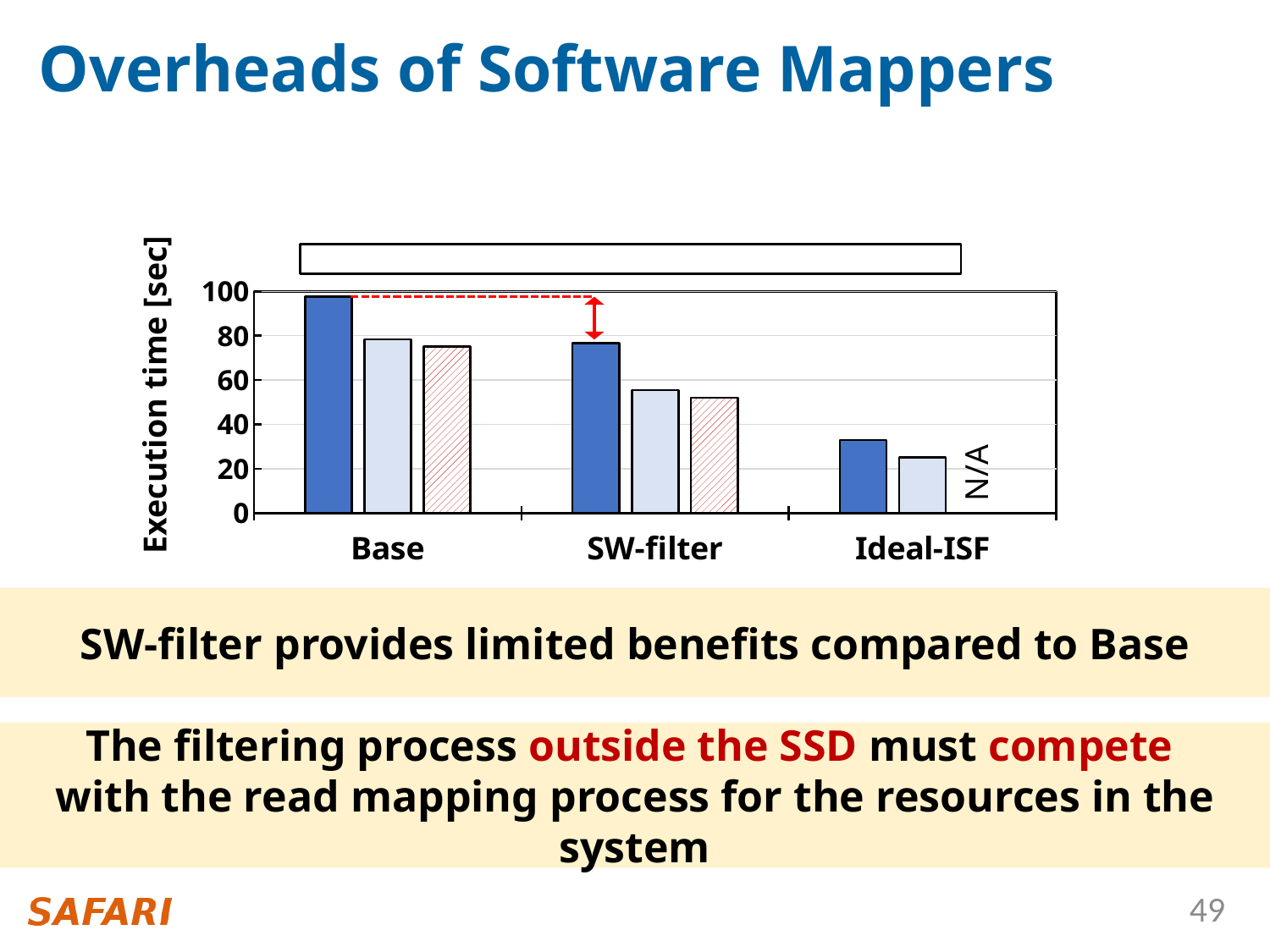
Is the dark blue bar for Ideal-ISF greater or less than 40? less Is the dark blue bar for Base greater or less than 80? greater Is the dark blue bar for SW-filter greater or less than 60? greater What is the label of the y axis of the chart? Execution time [sec] Which is larger, the dark blue bar for Base or the dark blue bar for SW-filter? Base For which category is the third (red hatched) bar marked N/A? Ideal-ISF Do the dark blue bars rise or fall from Base to Ideal-ISF along the x axis? fall What kind of chart is shown on the slide? bar chart Which category has the tallest dark blue bar? Base How many categories are shown on the x axis of the chart? 3 Which category has the shortest dark blue bar? Ideal-ISF